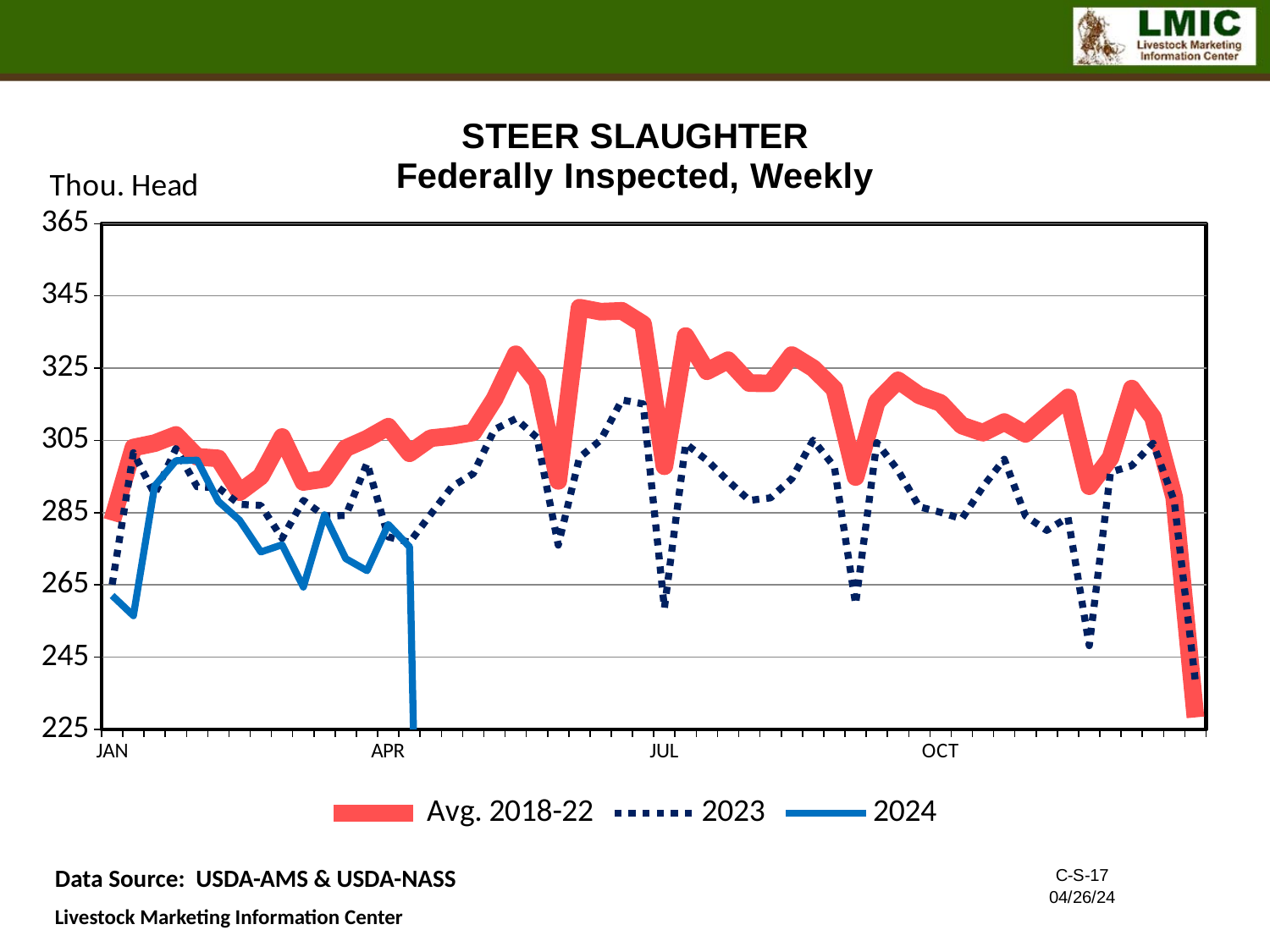
Is the lowest value of the 2023 series in December greater or less than 265? less How many month labels are shown on the x axis? 4 What kind of chart is shown on the slide? line chart Does the Avg. 2018-22 series generally rise or fall from JAN to JUL? rise What unit is shown on the y axis of the chart? Thou. Head Around JUL, which series is higher: Avg. 2018-22 or 2023? Avg. 2018-22 What is the title of the chart? STEER SLAUGHTER Federally Inspected, Weekly At the start of January, which series is higher: Avg. 2018-22 or 2024? Avg. 2018-22 Is the peak value of the Avg. 2018-22 series around late June greater or less than 325? greater Which series is highest for most of the year? Avg. 2018-22 How many series does the legend list? 3 Is the value of the 2024 series at the start of January greater or less than 285? less